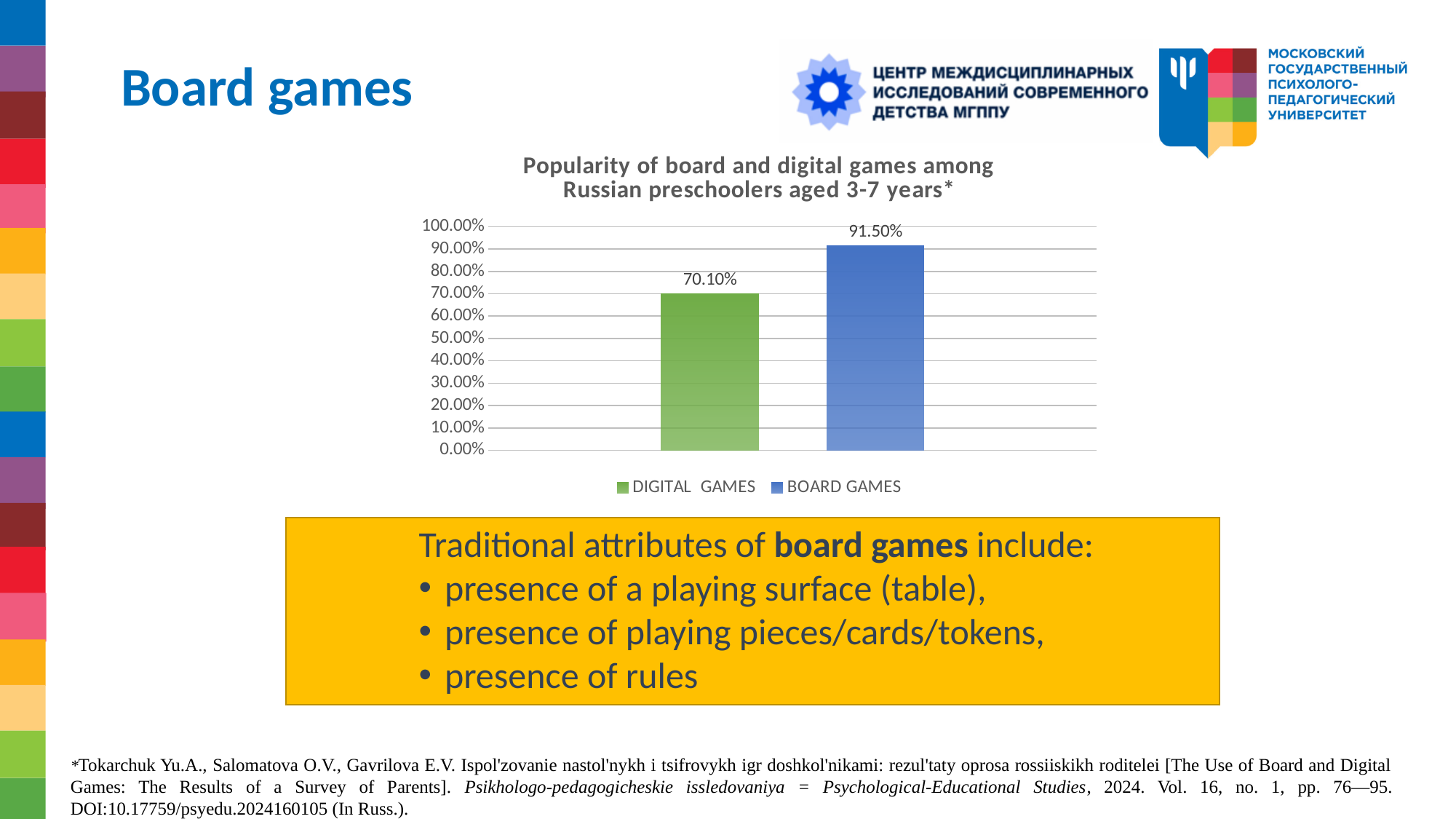
What is the value for BOARD GAMES? 91.50% What is the title of the chart? Popularity of board and digital games among Russian preschoolers aged 3-7 years* Is the value for DIGITAL GAMES greater or less than 80.00%? less How many bars are plotted in the chart? 2 What kind of chart is shown on the slide? bar chart How many series does the legend list? 2 Which is larger, the value for DIGITAL GAMES or the value for BOARD GAMES? BOARD GAMES Is the value for BOARD GAMES greater or less than 90.00%? greater What is the difference between the BOARD GAMES value and the DIGITAL GAMES value? 21.40% Which series has the lowest value? DIGITAL GAMES What is the value for DIGITAL GAMES? 70.10% Which series has the highest value? BOARD GAMES